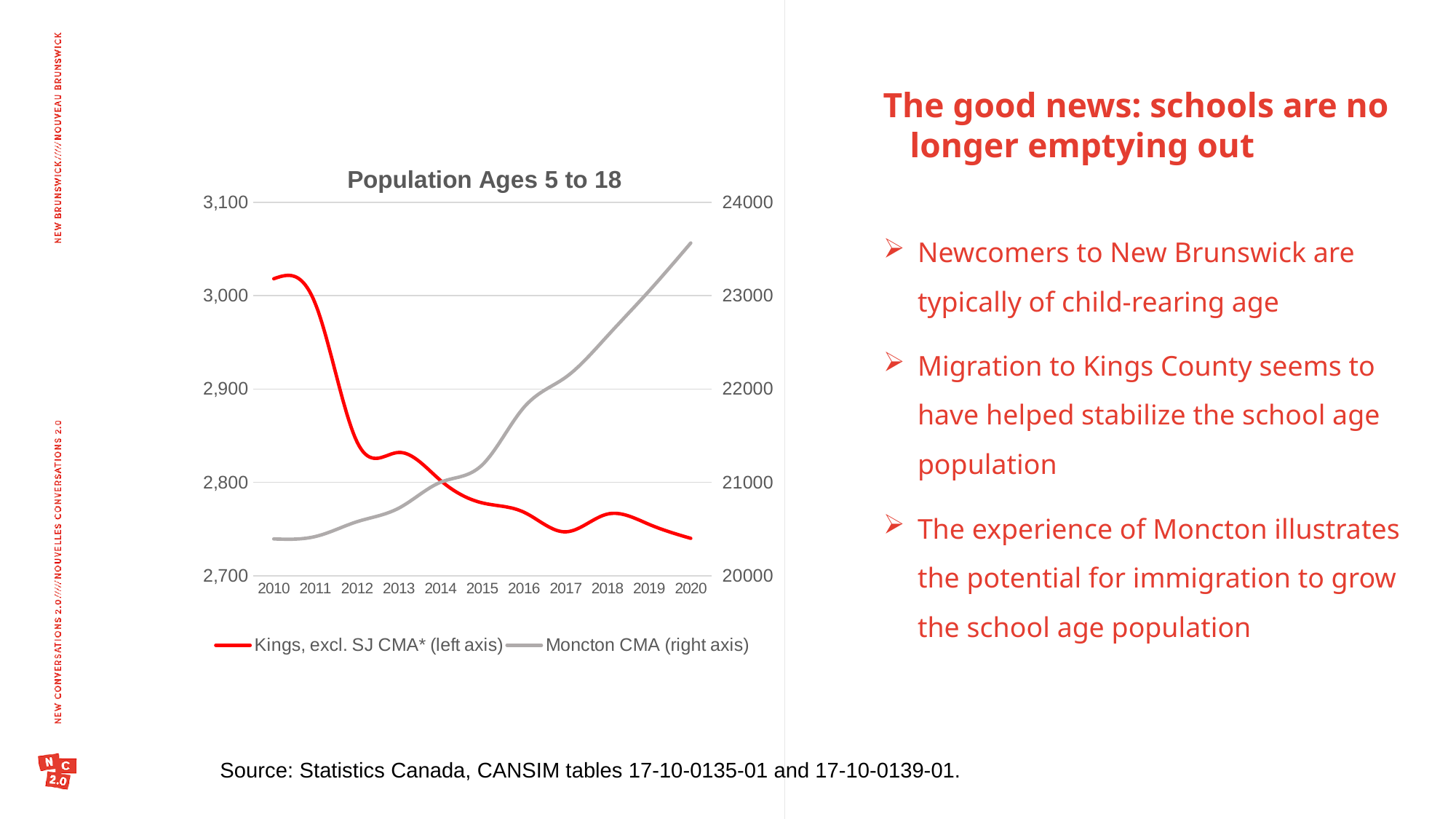
What kind of chart is shown on the slide? Line chart How many years are plotted along the x axis of the chart? 11 Does the Moncton CMA line rise or fall from 2010 to 2020? Rises What is the title of the chart? Population Ages 5 to 18 Is the Kings, excl. SJ CMA value for 2020 greater or less than 2,800? less Is the Moncton CMA value for 2010 greater or less than 21000? less In which year is the Moncton CMA value highest? 2020 Does the Kings, excl. SJ CMA line rise or fall overall from 2010 to 2020? Falls How many series does the chart's legend list? 2 Is the Moncton CMA value for 2020 greater or less than 23000? greater In which year is the Kings, excl. SJ CMA value highest? 2010 Which series is drawn in red in the chart? Kings, excl. SJ CMA* (left axis)